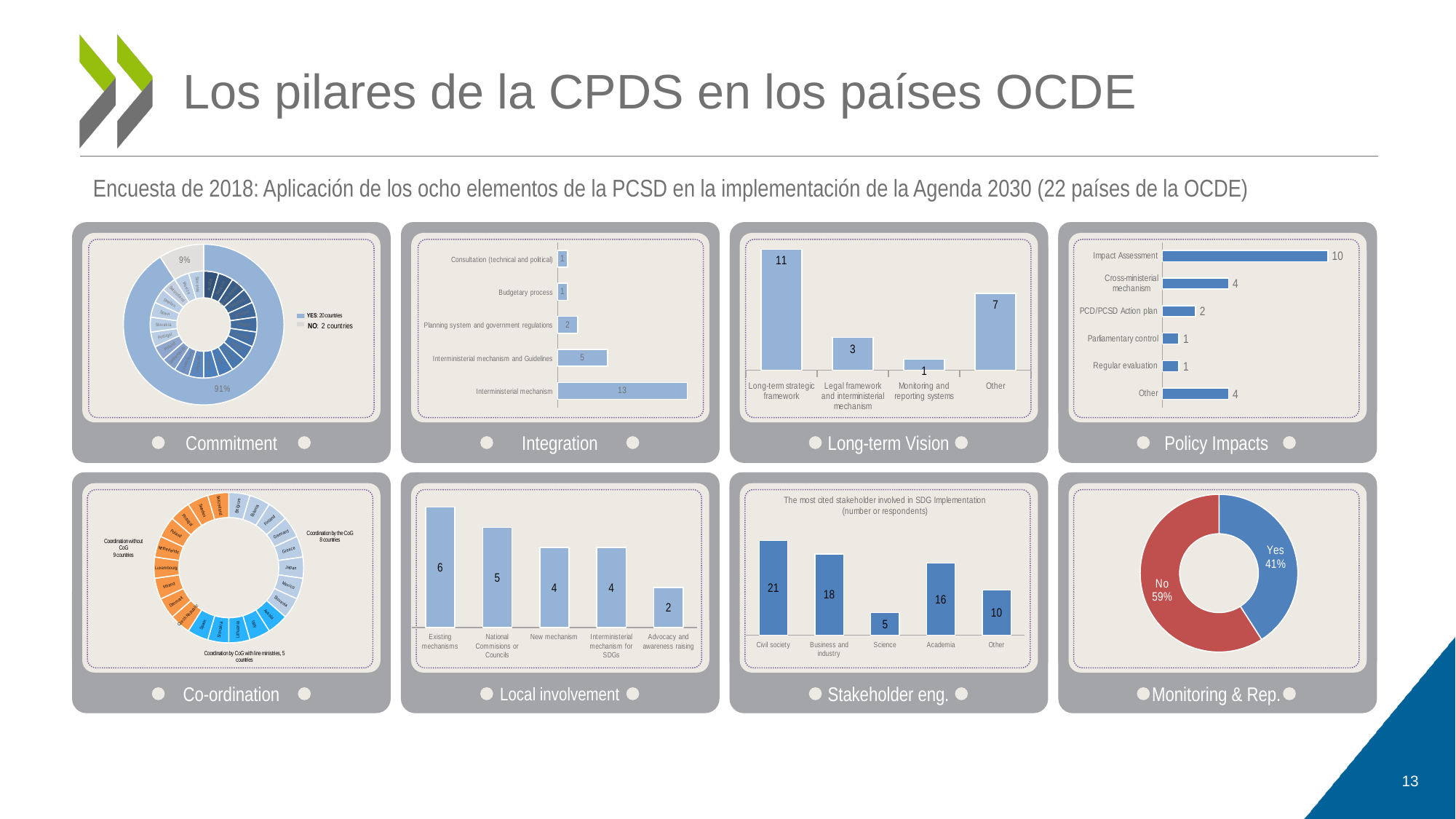
In the Local involvement chart, how many categories are shown? 5 In the Monitoring & Rep. chart, what share of the pie is No? 59% What kind of chart is shown in the Commitment panel? Donut (pie) chart In the Stakeholder eng. chart, which stakeholder has the lowest value? Science In the Stakeholder eng. chart, what is the value for Business and industry? 18 In the Stakeholder eng. chart, which is larger, Academia or Other? Academia In the Long-term Vision chart, what is the value for Other? 7 In the Policy Impacts chart, what is the value for Impact Assessment? 10 In the Local involvement chart, what is the value for Advocacy and awareness raising? 2 In the Policy Impacts chart, what is the difference between Impact Assessment and Cross-ministerial mechanism? 6 In the Long-term Vision chart, which category has the highest value? Long-term strategic framework In the Integration chart, what is the value for Interministerial mechanism? 13